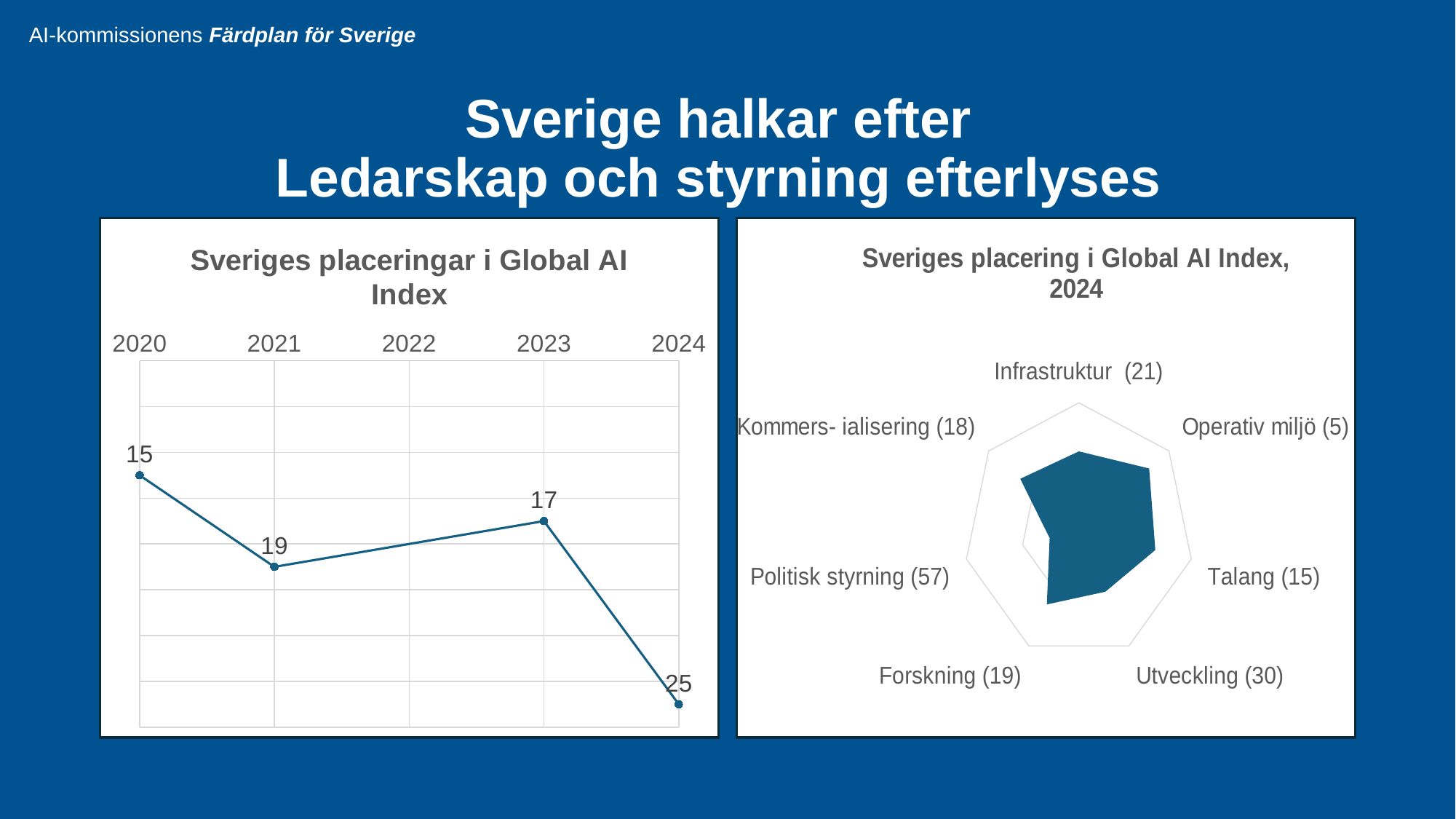
How many categories are shown in the chart 'Sveriges placering i Global AI Index, 2024'? 7 In the chart 'Sveriges placeringar i Global AI Index', does the value rise or fall from 2023 to 2024? rise In the chart 'Sveriges placeringar i Global AI Index', what is the difference between the values for 2024 and 2023? 8 In the chart 'Sveriges placeringar i Global AI Index', what is the value for 2024? 25 In the chart 'Sveriges placeringar i Global AI Index', which year has the highest value? 2024 In the chart 'Sveriges placeringar i Global AI Index', what is the value for 2020? 15 In the chart 'Sveriges placeringar i Global AI Index', which is larger, the value for 2021 or the value for 2023? 2021 What kind of chart is 'Sveriges placeringar i Global AI Index'? line chart In the chart 'Sveriges placeringar i Global AI Index', which year has the lowest value? 2020 What kind of chart is 'Sveriges placering i Global AI Index, 2024'? radar chart In the chart 'Sveriges placering i Global AI Index, 2024', what is the value for Politisk styrning? 57